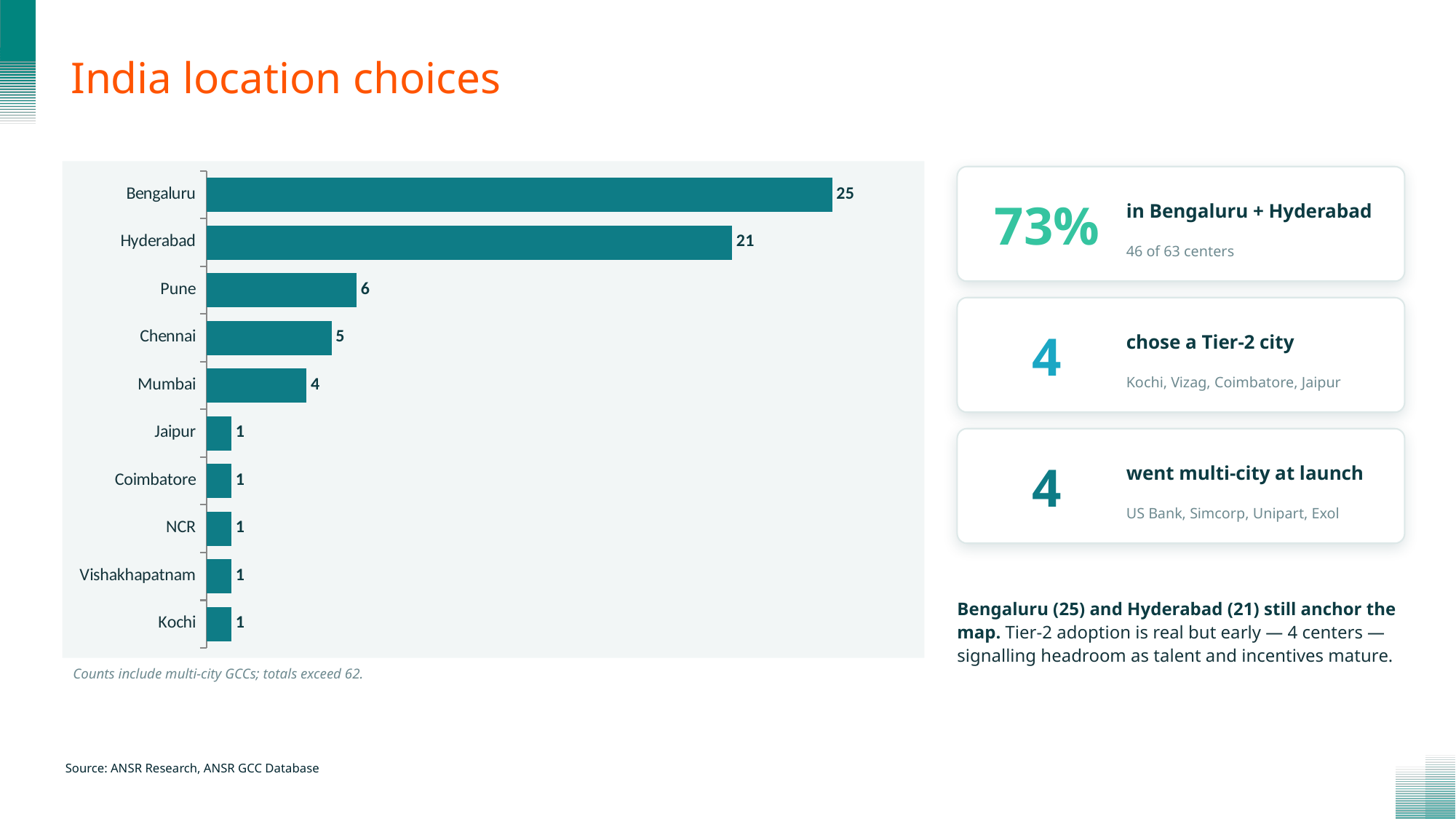
What is the difference between the values for Bengaluru and Hyderabad? 4 What is the note printed below the chart? Counts include multi-city GCCs; totals exceed 62. What is the value for Hyderabad? 21 What is the value for Bengaluru? 25 What is the difference between the values for Pune and Chennai? 1 Which is larger, the value for Chennai or the value for Mumbai? Chennai What kind of chart is shown on the slide? Bar chart What is the value for Pune? 6 What is the value for Mumbai? 4 How many cities are shown in the chart? 10 Which city has the highest value? Bengaluru How many cities have a value of 1? 5